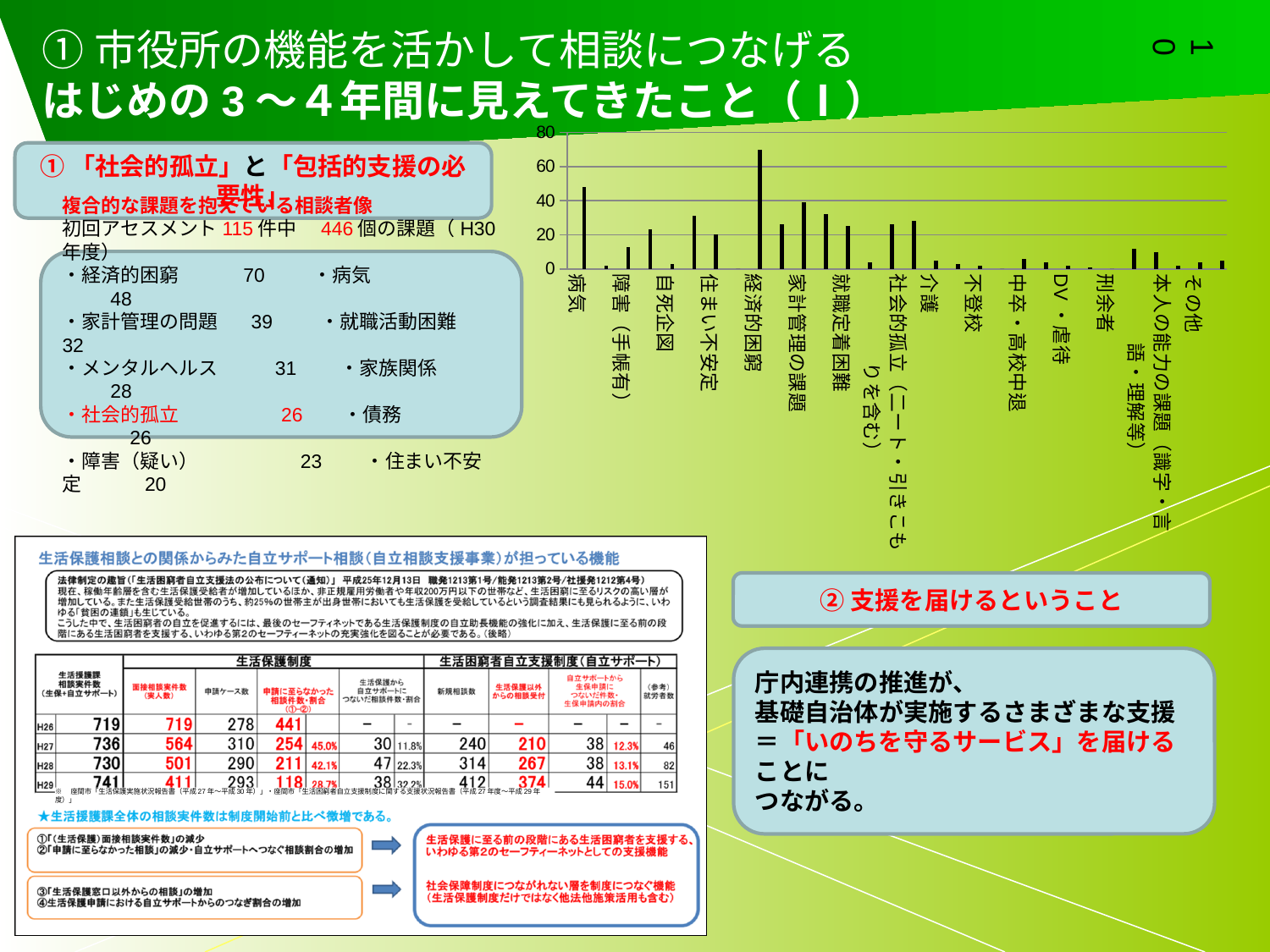
In the bar chart, which category has the highest value? 経済的困窮 In the bar chart, is the value for 病気 greater or less than 40? greater In the bar chart, is the value for 介護 greater or less than 20? less In the bar chart, which is larger, the value for 病気 or the value for 障害（手帳有）? 病気 What is the highest value shown on the vertical axis of the bar chart? 80 In the bar chart, is the value for 不登校 greater or less than 20? less What kind of chart is shown at the top right of the slide? bar chart In the bar chart, which is larger, the value for 経済的困窮 or the value for 家計管理の課題? 経済的困窮